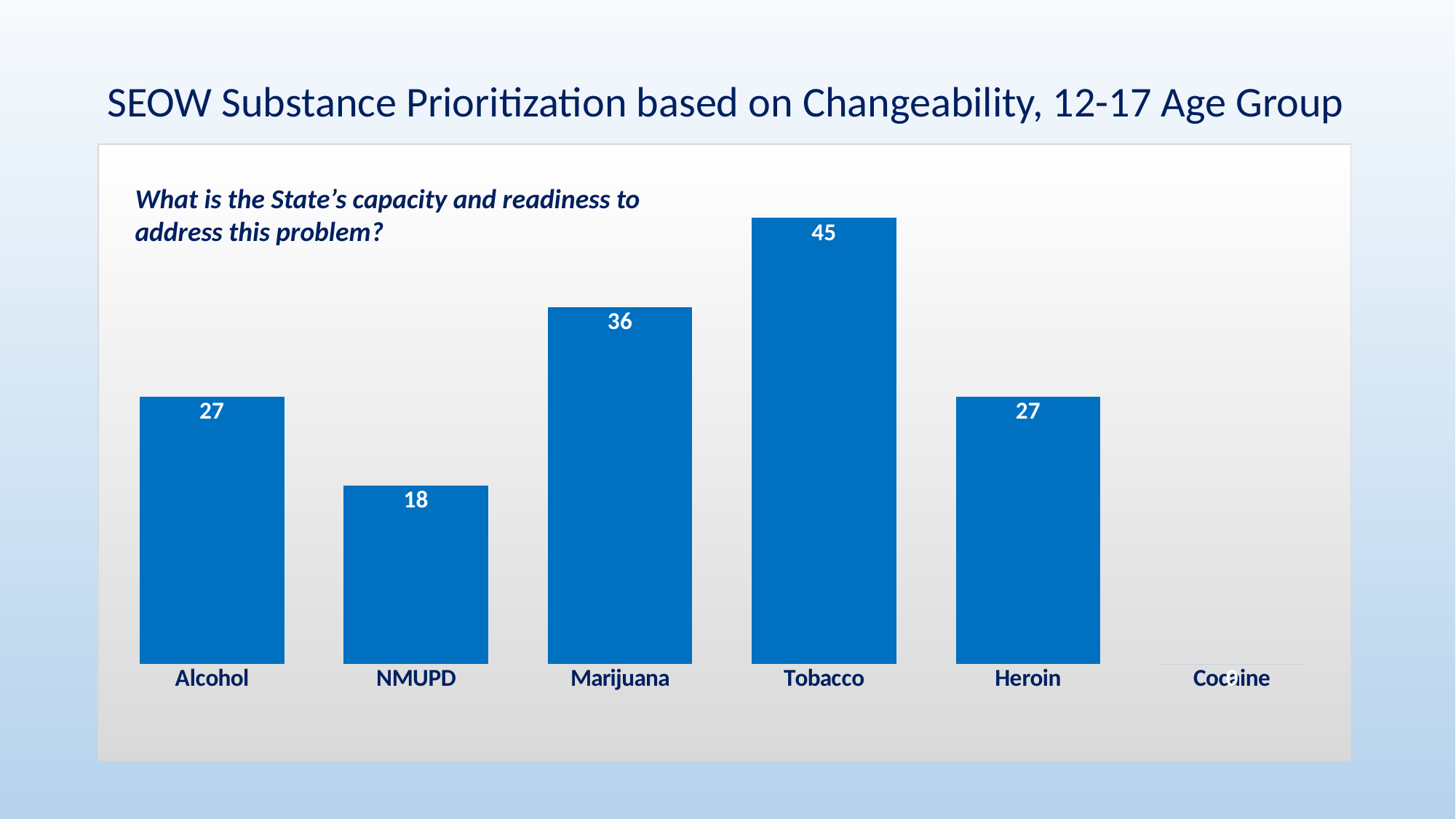
What is the difference between the values for Marijuana and NMUPD? 18 What is the value for NMUPD? 18 Which is larger, the value for Marijuana or the value for Heroin? Marijuana How many categories are shown on the x axis? 6 What is the difference between the values for Tobacco and Marijuana? 9 What kind of chart is shown on the slide? Bar chart Which category has the lowest value? Cocaine What is the value for Marijuana? 36 What is the value for Tobacco? 45 What question is written in italics inside the chart area? What is the State's capacity and readiness to address this problem? Which category has the highest value? Tobacco What is the value for Heroin? 27